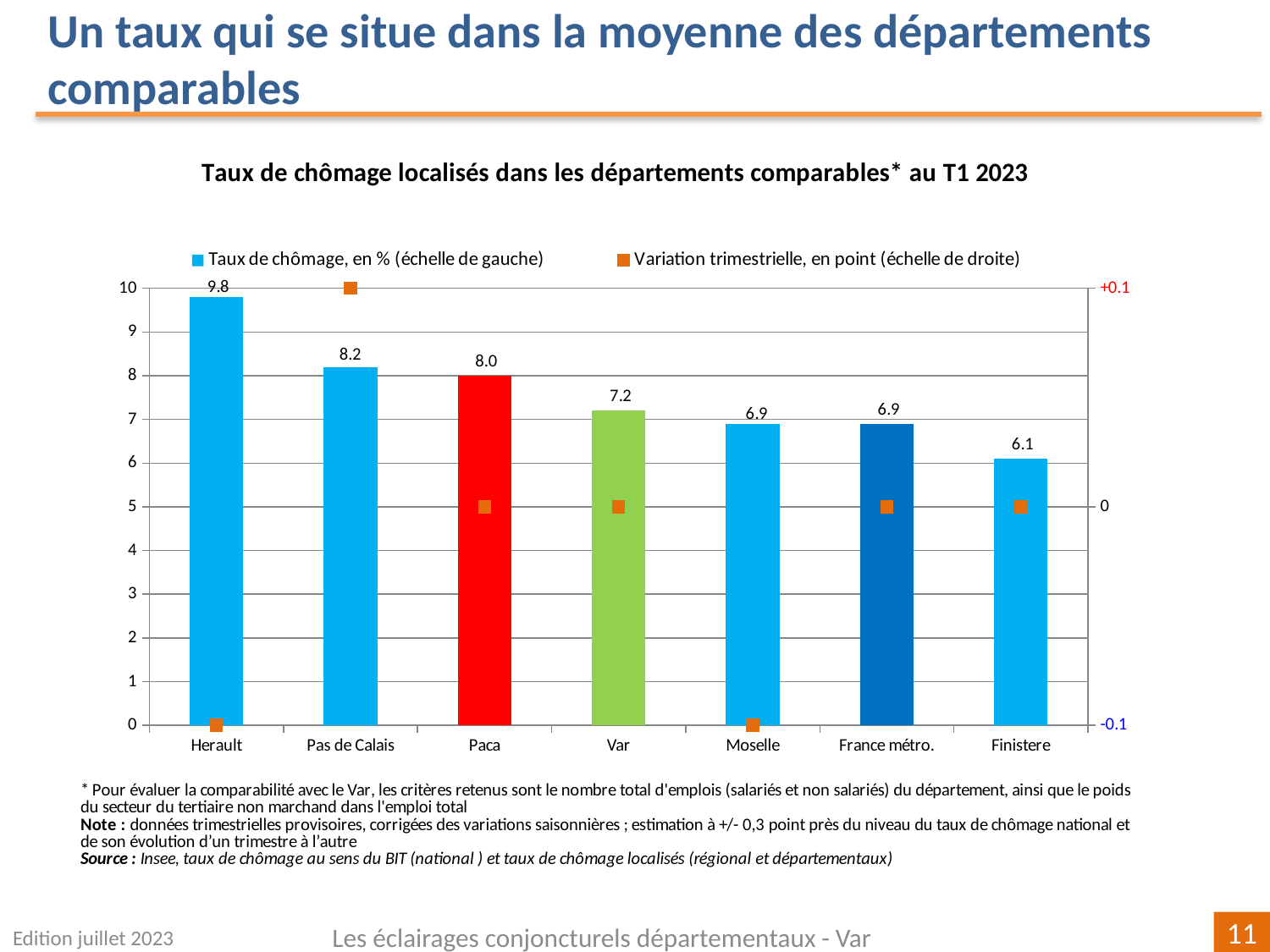
How many categories are shown on the x axis of the chart? 7 Which has a higher unemployment rate, Paca or Var? Paca What is the quarterly variation (Variation trimestrielle, en point) for Pas de Calais? +0.1 How many series does the legend list? 2 Which category has the highest unemployment rate? Herault What is the quarterly variation (Variation trimestrielle, en point) for Moselle? -0.1 What is the unemployment rate (Taux de chômage, en %) for Var? 7.2 What kind of chart is used to show the unemployment rates? Bar chart What is the unemployment rate (Taux de chômage, en %) for Herault? 9.8 Which category has the lowest unemployment rate? Finistere What is the difference between the unemployment rates of Herault and Pas de Calais? 1.6 What is the unemployment rate (Taux de chômage, en %) for Finistere? 6.1